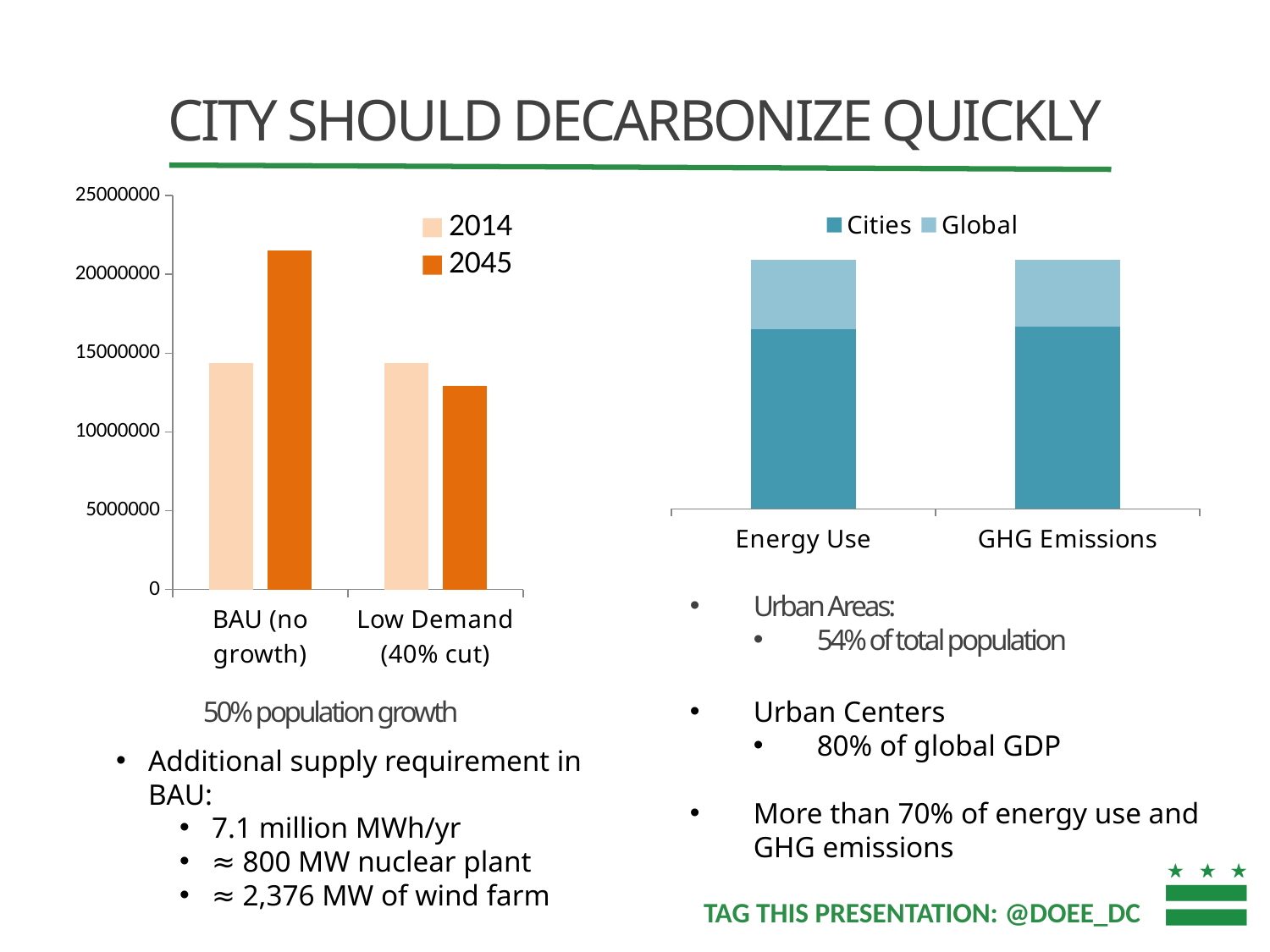
In the left chart, is the 2045 value for BAU (no growth) greater or less than 20000000? greater In the right chart, which series makes up the larger part of the Energy Use bar: Cities or Global? Cities How many series does the legend of the left chart list? 2 How many series does the legend of the right chart list? 2 In the left chart, which is larger for Low Demand (40% cut): the 2014 value or the 2045 value? 2014 In the left chart, which category has the larger 2045 value: BAU (no growth) or Low Demand (40% cut)? BAU (no growth) What kind of chart is the chart on the right of the slide? bar chart In the left chart, is the 2045 value for Low Demand (40% cut) greater or less than 15000000? less What kind of chart is the chart on the left of the slide? bar chart In the left chart, which bar is the tallest? 2045 for BAU (no growth) What are the two categories on the x axis of the right chart? Energy Use and GHG Emissions How many categories are shown on the x axis of the left chart? 2